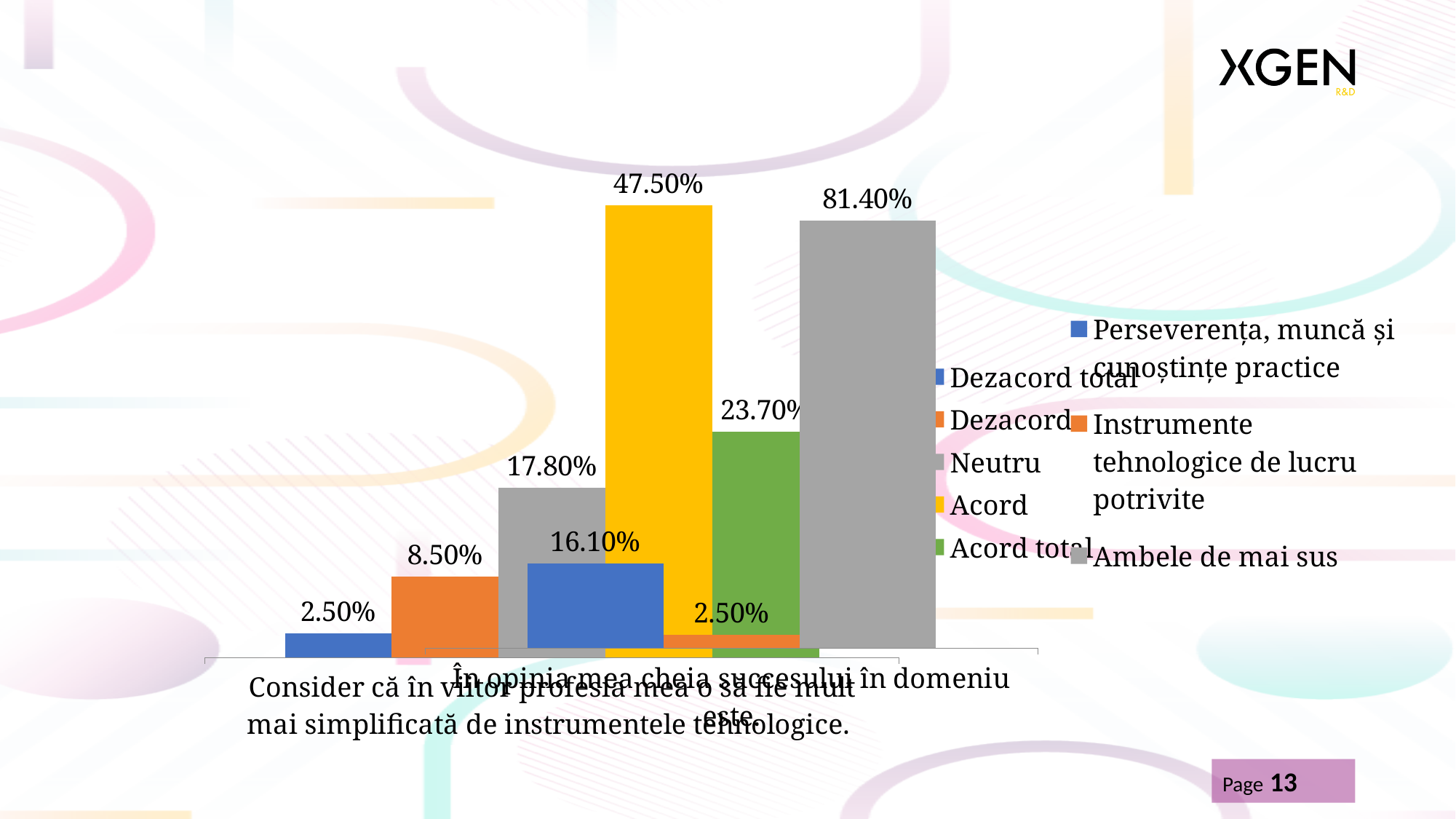
In the chart titled "Consider că în viitor profesia mea o să fie mult mai simplificată de instrumentele tehnologice.", which category has the highest value? Acord In the chart titled "Consider că în viitor profesia mea o să fie mult mai simplificată de instrumentele tehnologice.", how many entries does the legend list? 5 In the chart titled "Consider că în viitor profesia mea o să fie mult mai simplificată de instrumentele tehnologice.", what is the value for Dezacord? 8.50% In the chart titled "În opinia mea cheia succesului în domeniu este.", what is the value for Instrumente tehnologice de lucru potrivite? 2.50% In the chart titled "Consider că în viitor profesia mea o să fie mult mai simplificată de instrumentele tehnologice.", what is the value for Acord? 47.50% In the chart titled "Consider că în viitor profesia mea o să fie mult mai simplificată de instrumentele tehnologice.", which category has the lowest value? Dezacord total In the chart titled "Consider că în viitor profesia mea o să fie mult mai simplificată de instrumentele tehnologice.", what is the difference between Acord and Acord total? 23.80% In the chart titled "În opinia mea cheia succesului în domeniu este.", what is the value for Ambele de mai sus? 81.40% In the chart titled "În opinia mea cheia succesului în domeniu este.", what is the value for Perseverența, muncă și cunoștințe practice? 16.10% In the chart titled "În opinia mea cheia succesului în domeniu este.", which is larger: Perseverența, muncă și cunoștințe practice or Instrumente tehnologice de lucru potrivite? Perseverența, muncă și cunoștințe practice What type of chart is the chart titled "În opinia mea cheia succesului în domeniu este."? Bar chart In the chart titled "Consider că în viitor profesia mea o să fie mult mai simplificată de instrumentele tehnologice.", what is the value for Acord total? 23.70%